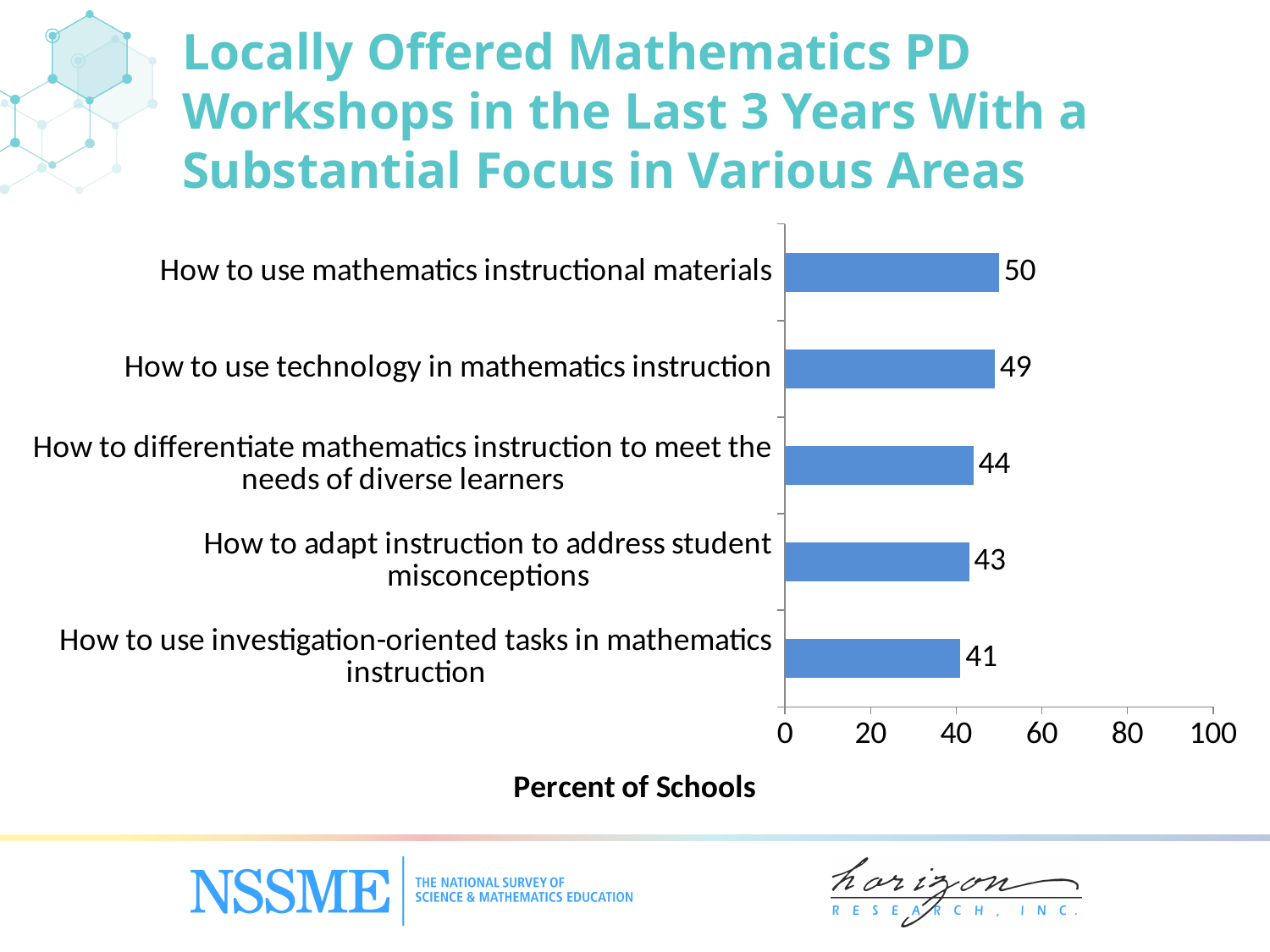
How many categories are shown in the chart? 5 What percent of schools offered locally offered mathematics PD workshops with a substantial focus on how to use mathematics instructional materials? 50 What is the label of the horizontal axis? Percent of Schools What is the difference between the values for 'How to differentiate mathematics instruction to meet the needs of diverse learners' and 'How to adapt instruction to address student misconceptions'? 1 What is the difference between the values for 'How to use mathematics instructional materials' and 'How to use investigation-oriented tasks in mathematics instruction'? 9 What is the value for 'How to use investigation-oriented tasks in mathematics instruction'? 41 Which has a larger value: 'How to use technology in mathematics instruction' or 'How to differentiate mathematics instruction to meet the needs of diverse learners'? How to use technology in mathematics instruction What is the value for 'How to use technology in mathematics instruction'? 49 Which category has the lowest percent of schools? How to use investigation-oriented tasks in mathematics instruction What kind of chart is shown on the slide? Bar chart Which category has the highest percent of schools? How to use mathematics instructional materials What is the value for 'How to adapt instruction to address student misconceptions'? 43